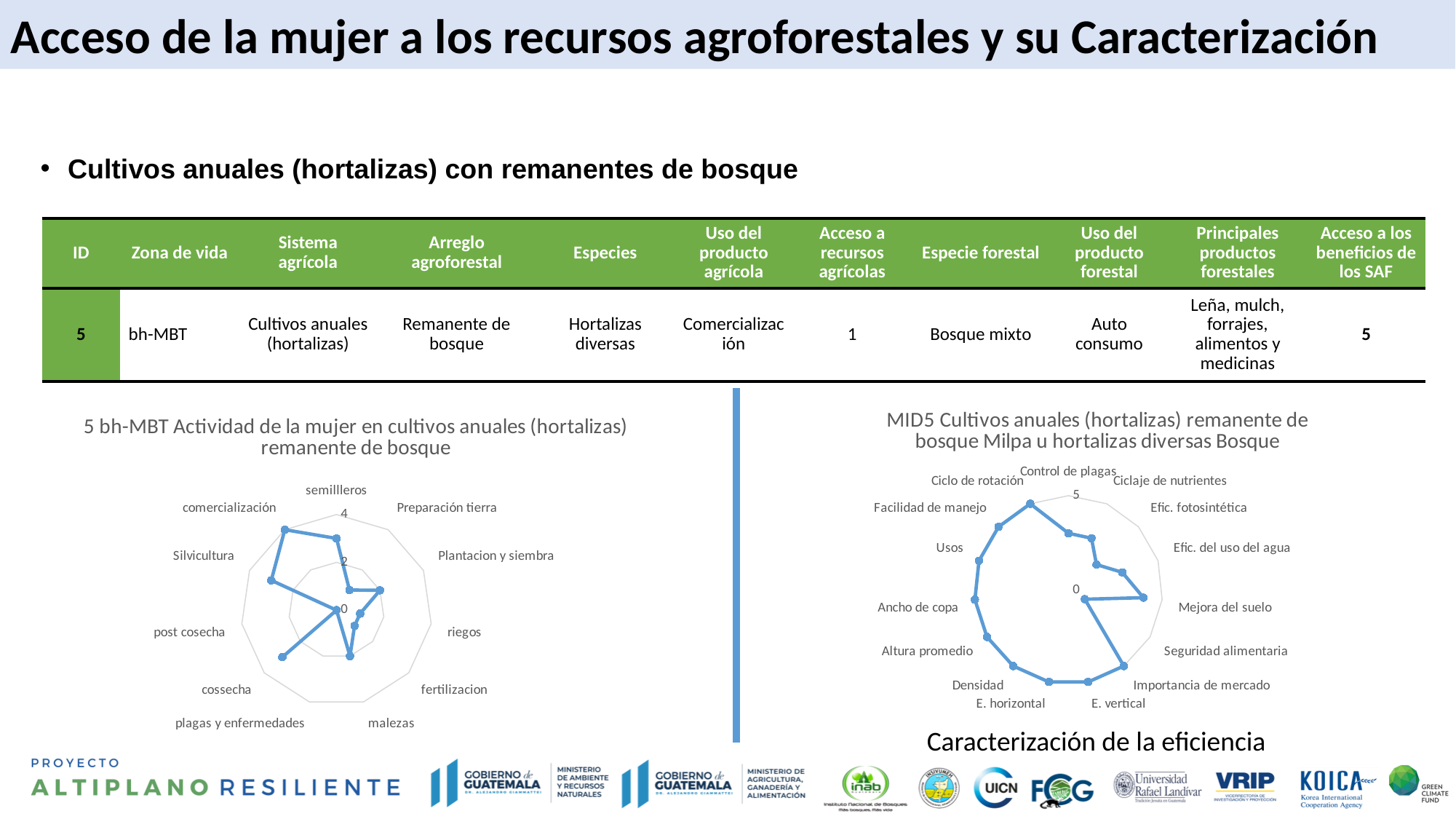
In the right chart (MID5 Cultivos anuales), which is larger, the value for Control de plagas or the value for Mejora del suelo? Mejora del suelo In the left chart (5 bh-MBT Actividad de la mujer), which is larger, the value for comercialización or the value for riegos? comercialización What kind of chart is the right chart titled 'MID5 Cultivos anuales (hortalizas) remanente de bosque Milpa u hortalizas diversas Bosque'? Radar chart In the left chart (5 bh-MBT Actividad de la mujer), is the value for plagas y enfermedades greater or less than 2? less In the left chart (5 bh-MBT Actividad de la mujer), how many categories are plotted around the radar? 11 In the left chart (5 bh-MBT Actividad de la mujer), is the value for comercialización greater or less than 2? greater What is the highest axis tick value shown on the right chart (MID5 Cultivos anuales)? 5 In the left chart (5 bh-MBT Actividad de la mujer), is the value for post cosecha greater or less than 2? less In the right chart (MID5 Cultivos anuales), which category has the lowest value? Seguridad alimentaria What kind of chart is the left chart titled '5 bh-MBT Actividad de la mujer en cultivos anuales (hortalizas) remanente de bosque'? Radar chart In the right chart (MID5 Cultivos anuales), how many categories are plotted around the radar? 15